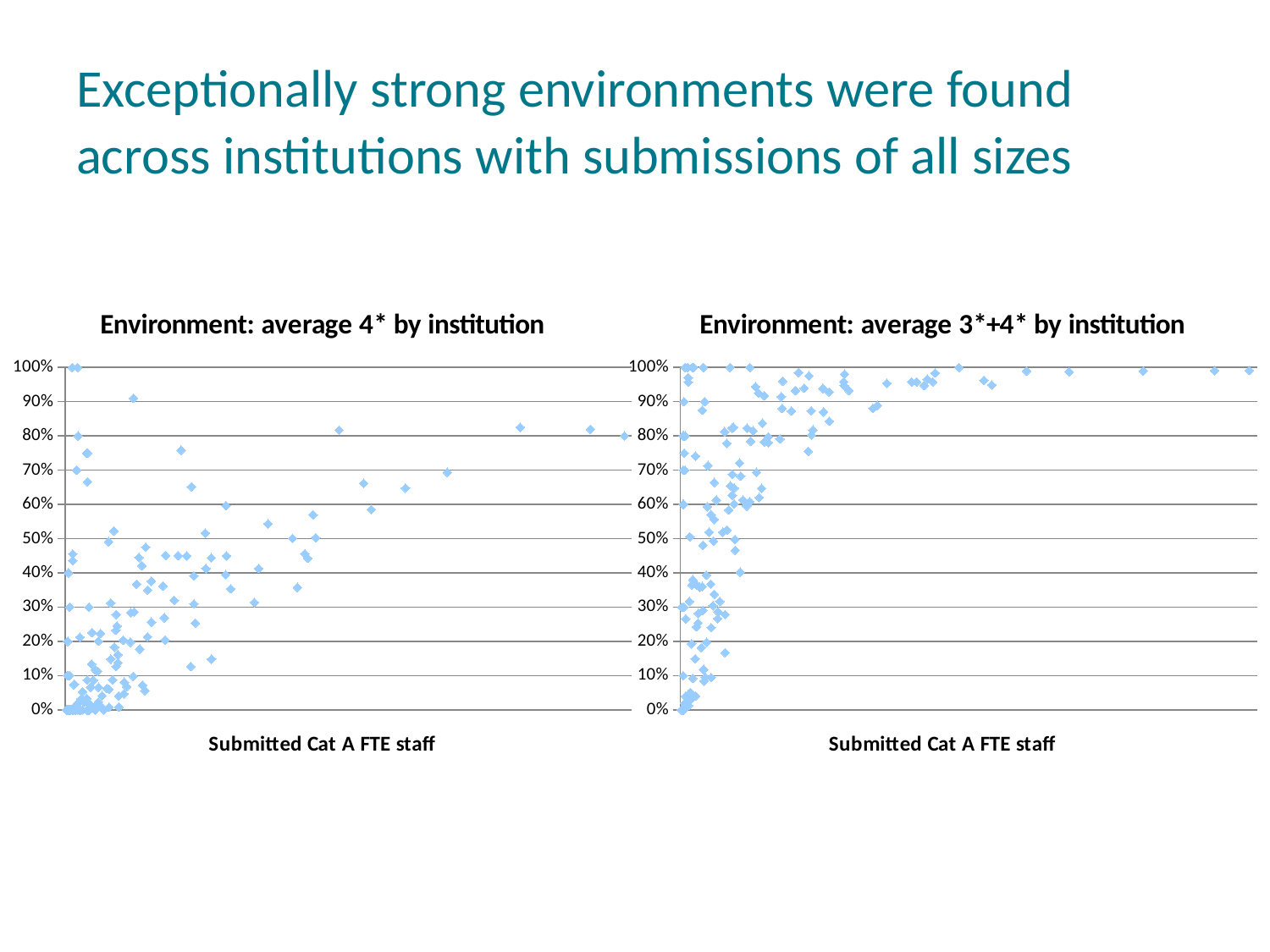
In the left chart, 'Environment: average 4* by institution', do the plotted values generally rise or fall as Submitted Cat A FTE staff increases? rise What type of chart is the left chart, 'Environment: average 4* by institution'? scatter chart Which chart has more points plotted above 80%, the left chart or the right chart? the right chart What is the lowest value shown on the y-axis of the right chart? 0% What is the title of the chart on the left? Environment: average 4* by institution In the right chart, are the points at the largest Submitted Cat A FTE staff values greater or less than 90%? greater How many charts are shown on the slide? 2 What is the x-axis label used on both charts? Submitted Cat A FTE staff In the right chart, 'Environment: average 3*+4* by institution', do the plotted values generally rise or fall as Submitted Cat A FTE staff increases? rise What type of chart is the right chart, 'Environment: average 3*+4* by institution'? scatter chart What is the highest value shown on the y-axis of the left chart? 100%